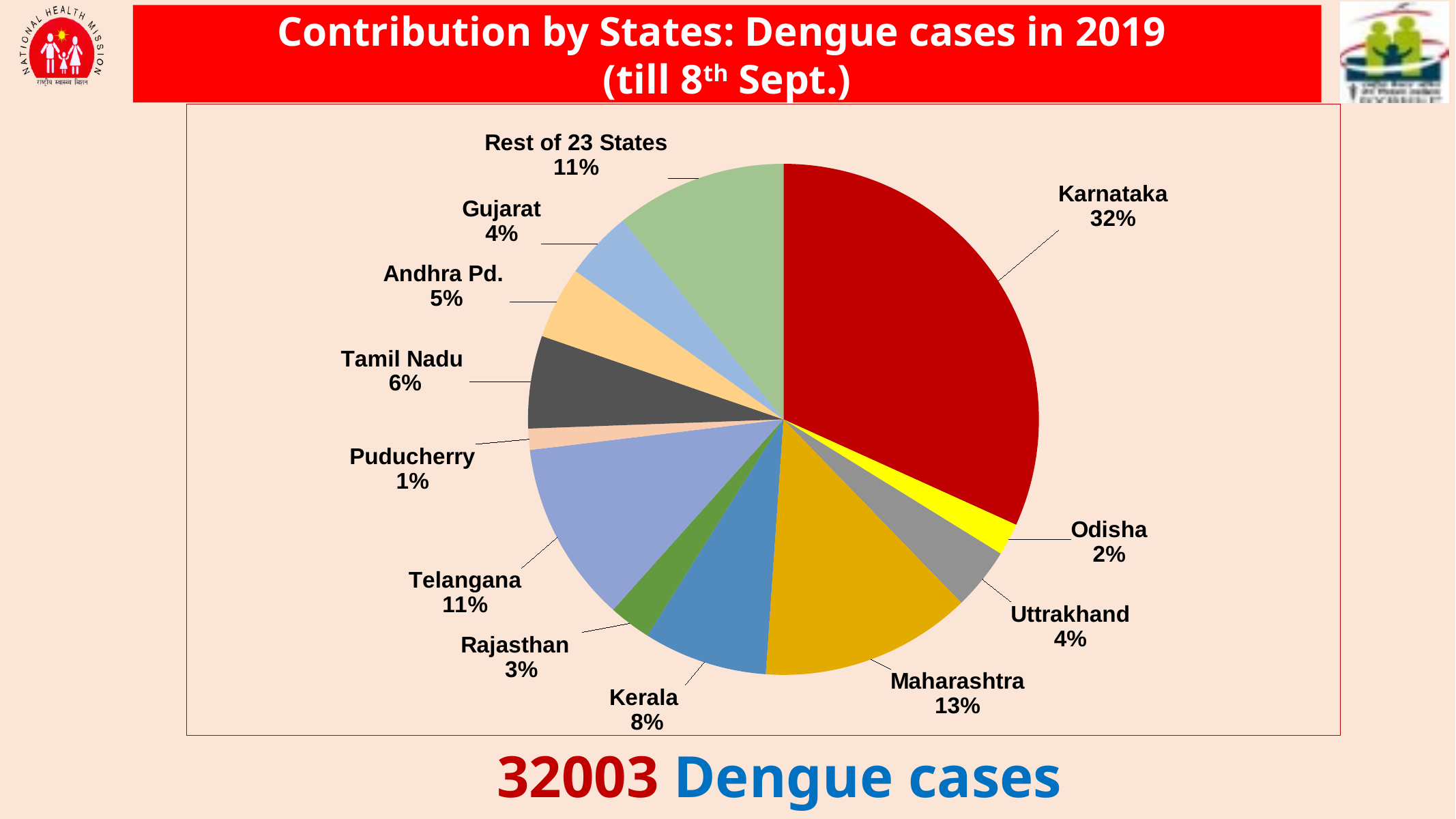
What share of dengue cases does Karnataka contribute? 32% What is the share for Kerala? 8% What percentage of dengue cases is attributed to Maharashtra? 13% Which has a larger share, Tamil Nadu or Andhra Pd.? Tamil Nadu What type of chart is shown on the slide? Pie chart What is the combined share of Telangana and Kerala? 19% How many slices does the pie chart have? 12 Which slice has the smallest share? Puducherry What total number of dengue cases is stated below the chart? 32003 What percentage is shown for Rest of 23 States? 11% Which state has the largest share of dengue cases? Karnataka What is the difference in percentage points between Karnataka and Maharashtra? 19